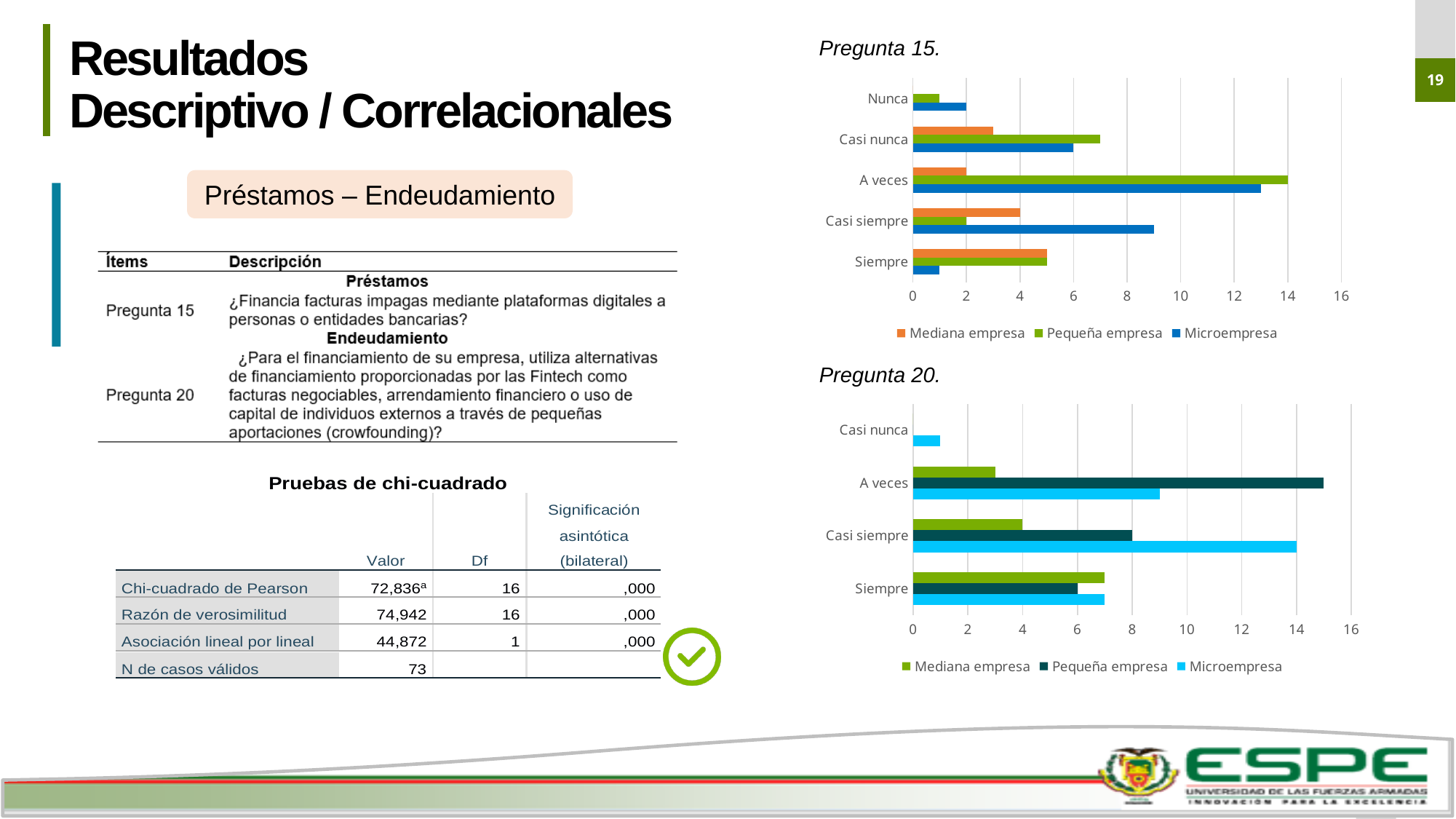
In the Pregunta 20 chart, is the Mediana empresa value for A veces greater or less than 4? less How many series does the legend of the Pregunta 15 chart list? 3 In the Pregunta 15 chart, for Casi siempre, which is larger: Microempresa or Mediana empresa? Microempresa In the Pregunta 20 chart, which category has the highest value for Pequeña empresa? A veces In the Pregunta 15 chart, which category has the lowest value for Microempresa? Siempre How many categories are shown on the Pregunta 20 chart? 4 In the Pregunta 20 chart, which series is shown in light blue according to the legend? Microempresa How many categories are shown on the Pregunta 15 chart? 5 In the Pregunta 15 chart, is the Microempresa value for A veces greater or less than 10? greater What kind of chart is shown under Pregunta 15? Bar chart In the Pregunta 15 chart, which category has the highest value for Pequeña empresa? A veces In the Pregunta 20 chart, is the Microempresa value for Casi siempre greater or less than 12? greater